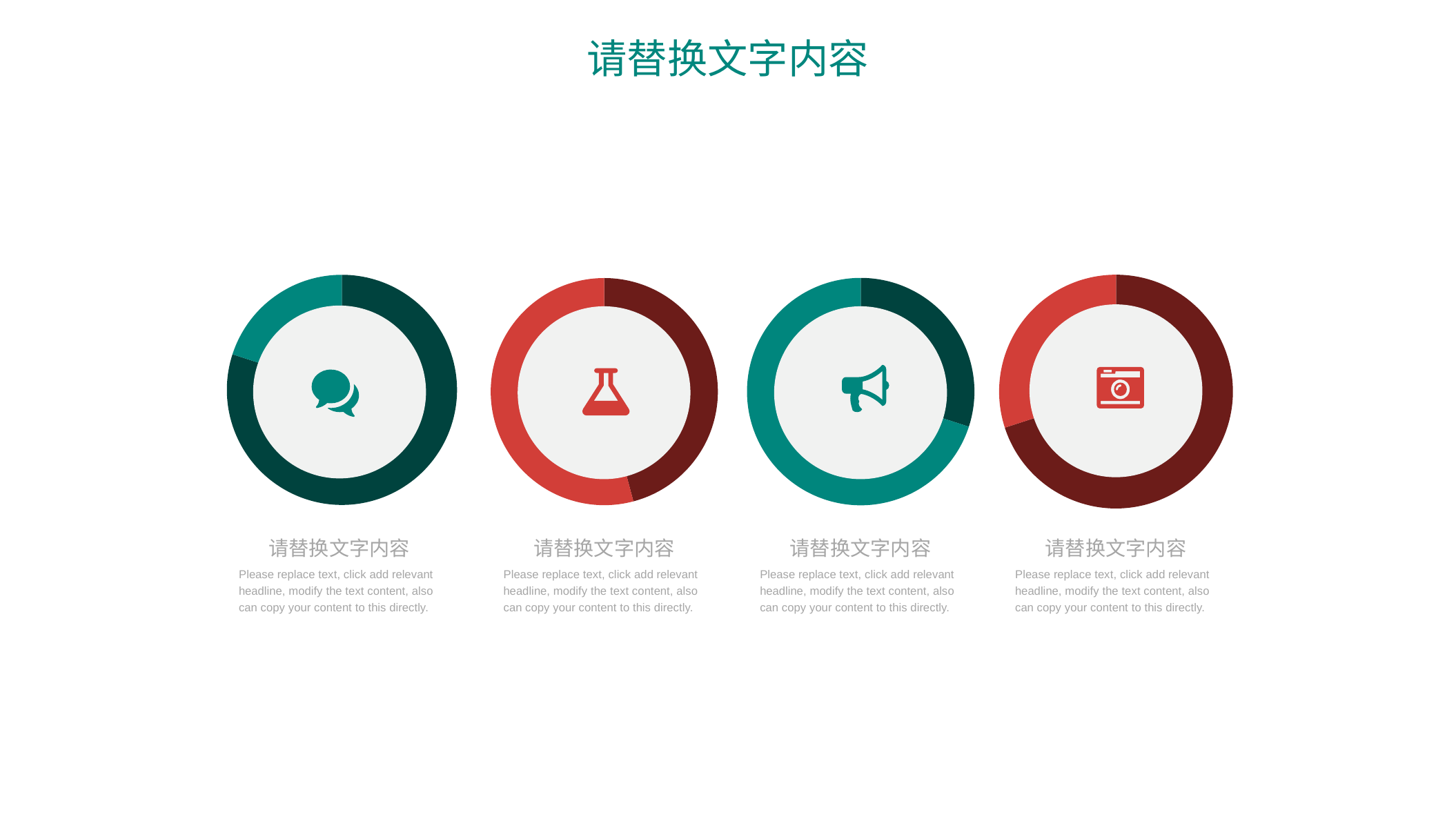
How many donut charts are shown on the slide? 4 In the leftmost donut chart, which segment is larger, the dark teal one or the light teal one? Dark teal What is the title shown at the top of the slide? 请替换文字内容 What colours are used in the second donut chart from the left? Light red and dark red What kind of chart is the leftmost chart on the slide? Donut chart How many segments does the rightmost donut chart have? 2 In the rightmost donut chart, which segment is larger, the dark red one or the light red one? Dark red Which of the four donut charts has the largest dark-coloured segment? The leftmost chart How many segments does the leftmost donut chart have? 2 In the third donut chart from the left, which segment is larger, the dark teal one or the light teal one? Light teal